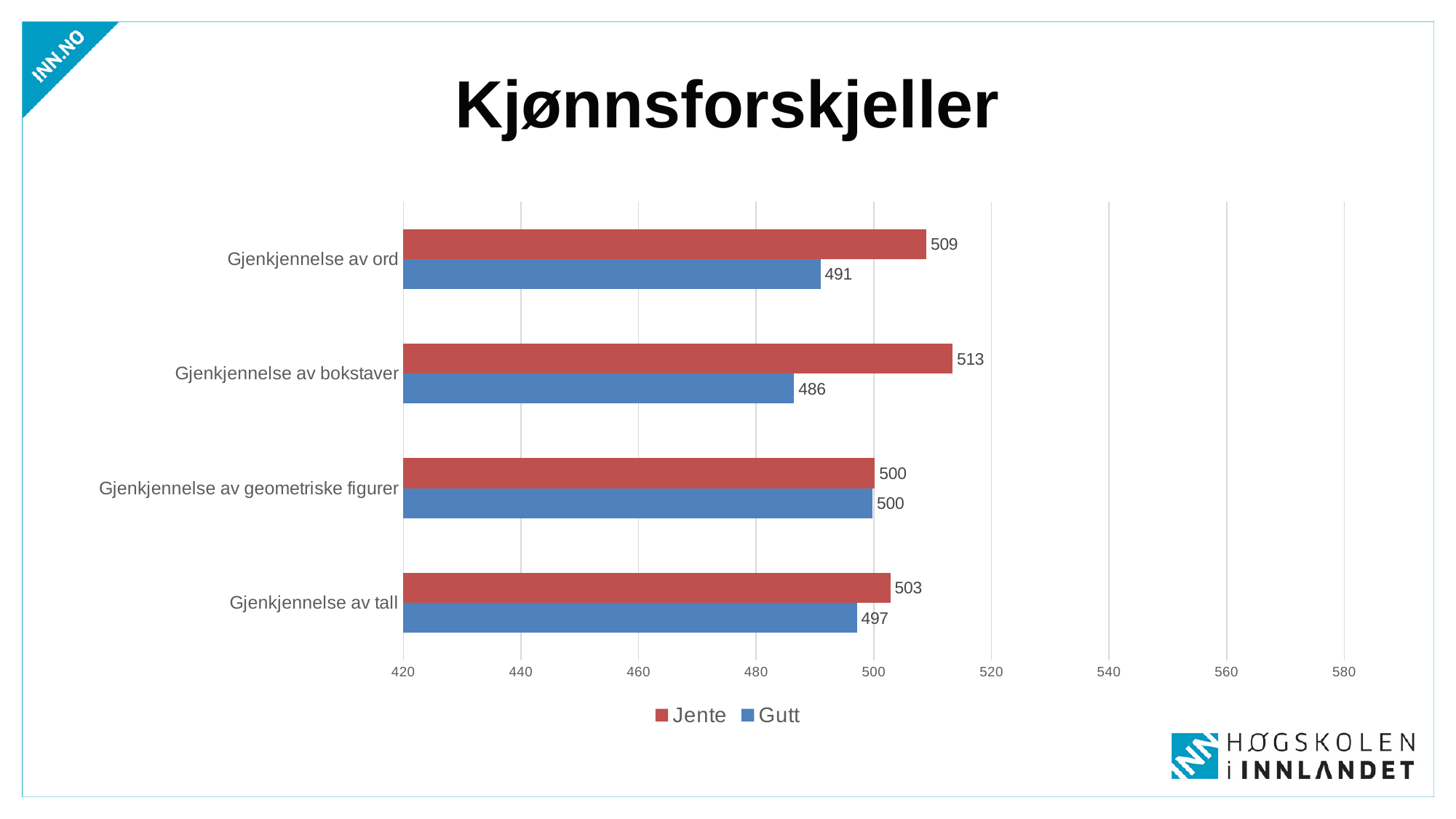
What is the difference between the Jente and Gutt values for Gjenkjennelse av bokstaver? 27 Which category has the highest Jente value? Gjenkjennelse av bokstaver Which category has the lowest Gutt value? Gjenkjennelse av bokstaver What is the difference between the Jente and Gutt values for Gjenkjennelse av ord? 18 What kind of chart is shown on the slide? Bar chart Which is larger for Gjenkjennelse av tall, the Jente value or the Gutt value? Jente How many series does the legend list? 2 How many categories are shown on the chart? 4 Is the Gutt value for Gjenkjennelse av ord greater or less than 500? less What is the Gutt value for Gjenkjennelse av bokstaver? 486 What is the Jente value for Gjenkjennelse av ord? 509 What is the Gutt value for Gjenkjennelse av tall? 497